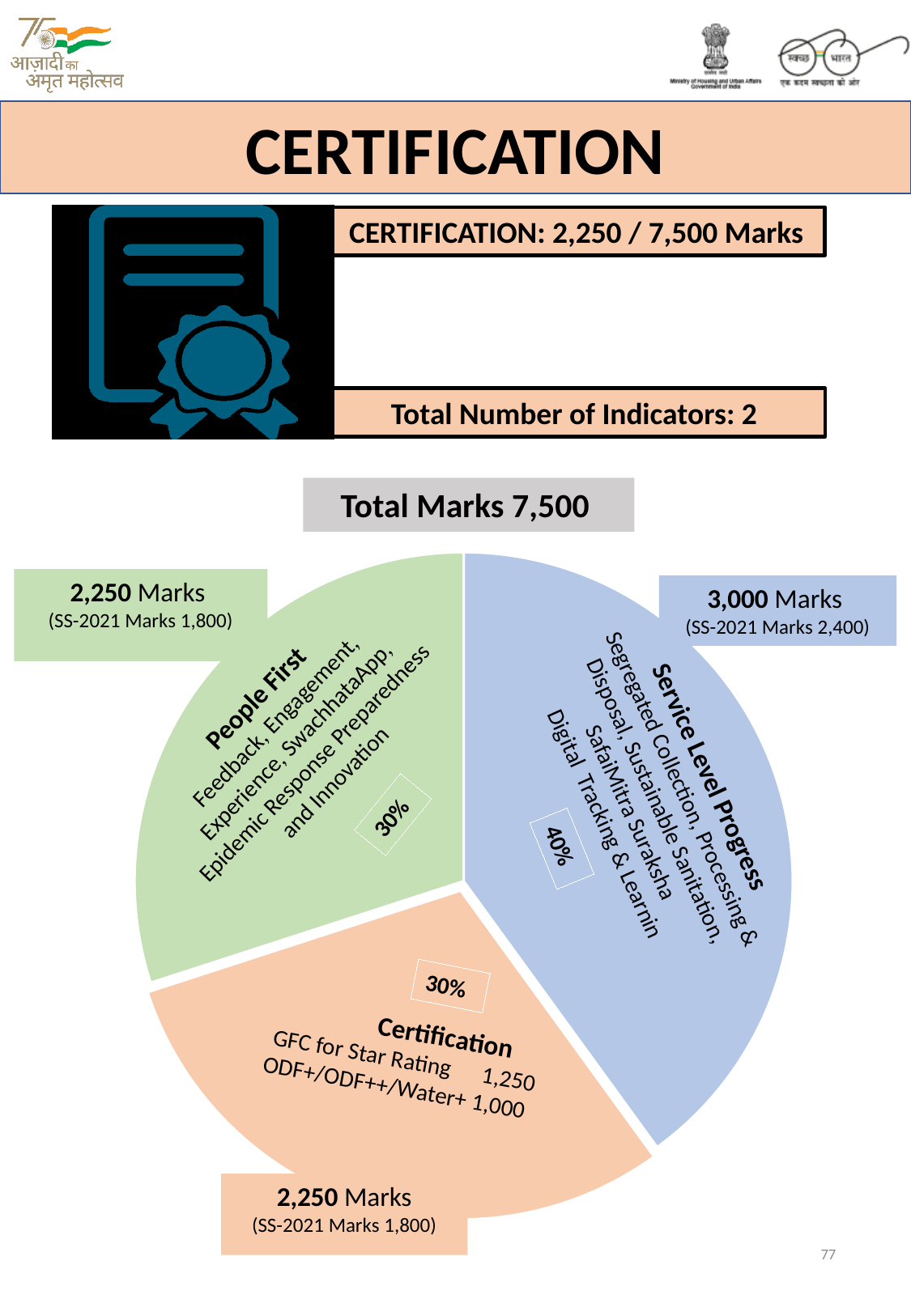
What is the difference in marks between Service Level Progress and Certification? 750 How many marks are allocated to People First? 2,250 Marks What were the SS-2021 marks for Service Level Progress? 2,400 How many marks are allocated to Service Level Progress? 3,000 Marks What percentage share does the People First slice have? 30% What percentage share does the Service Level Progress slice have? 40% How many marks are allocated to Certification? 2,250 Marks How many slices does the pie chart have? 3 What colour is the Certification slice of the pie chart? orange (peach) Which slice of the pie chart is the largest? Service Level Progress What is the total number of marks represented by the pie chart? 7,500 What kind of chart is shown on the slide? pie chart